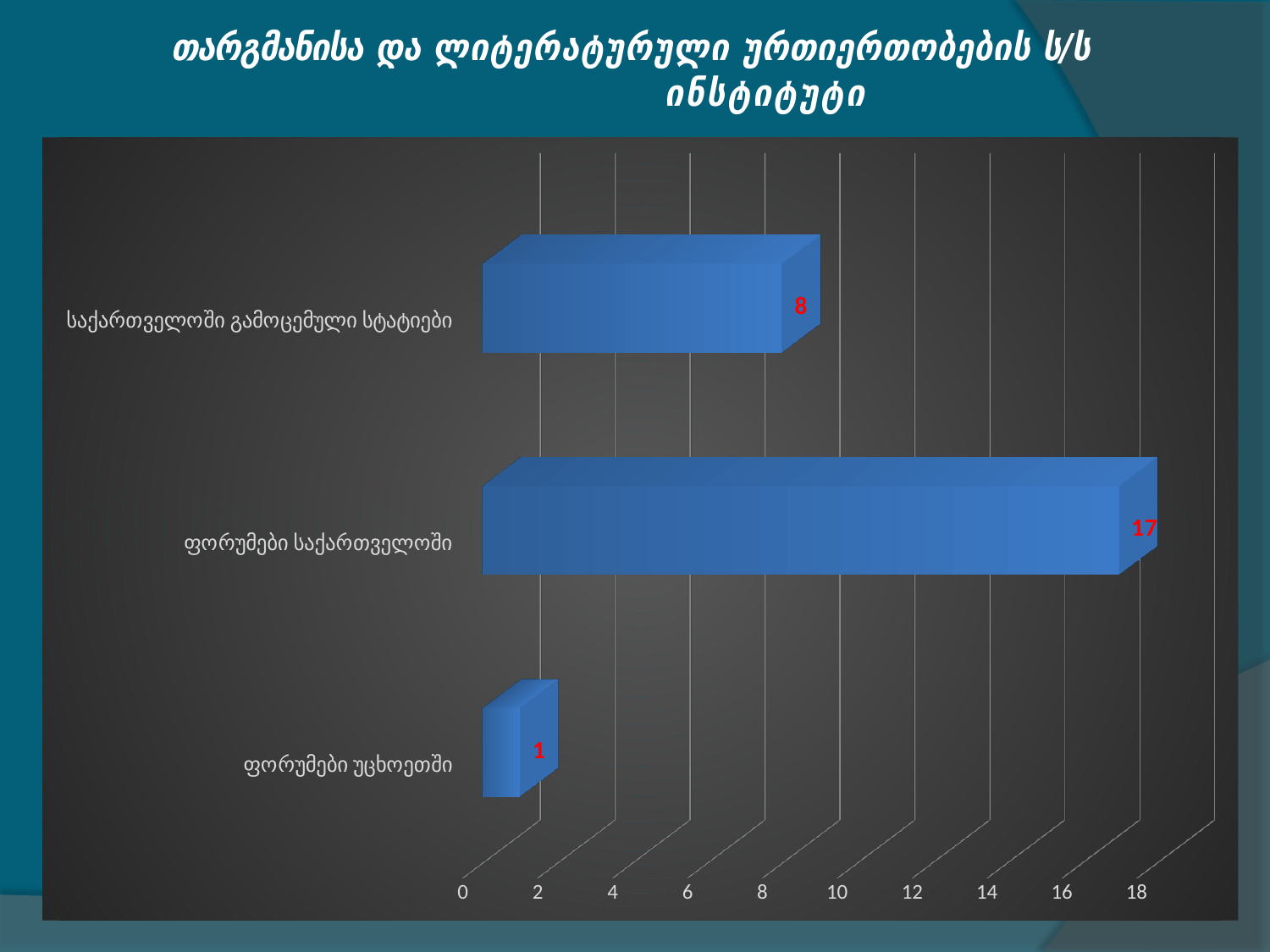
What is the value for ფორუმები საქართველოში? 17 What is the title of the slide? თარგმანისა და ლიტერატურული ურთიერთობების ს/ს ინსტიტუტი Which is larger, the value for საქართველოში გამოცემული სტატიები or the value for ფორუმები უცხოეთში? საქართველოში გამოცემული სტატიები What is the value for ფორუმები უცხოეთში? 1 Which category has the lowest value? ფორუმები უცხოეთში Is the value for ფორუმები საქართველოში greater or less than 10? greater What is the difference between the values for ფორუმები საქართველოში and საქართველოში გამოცემული სტატიები? 9 What is the value for საქართველოში გამოცემული სტატიები? 8 How many categories are shown in the chart? 3 Which category has the highest value? ფორუმები საქართველოში What is the difference between the values for ფორუმები საქართველოში and ფორუმები უცხოეთში? 16 What kind of chart is shown on the slide? bar chart